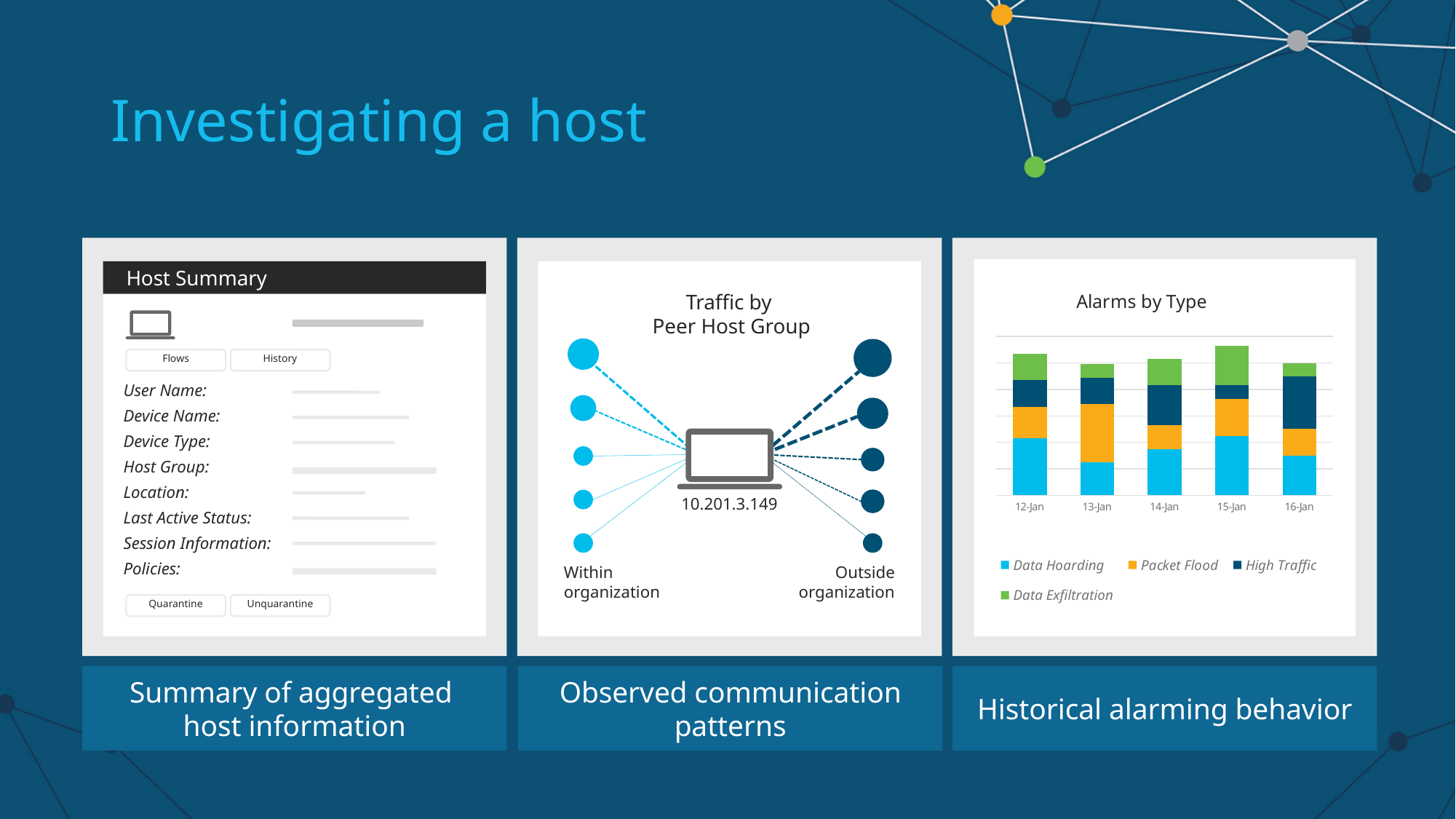
How many series does the legend of the Alarms by Type chart list? 4 What kind of chart is the Alarms by Type chart? Stacked bar chart Which series appears at the bottom of each stacked bar in the Alarms by Type chart? Data Hoarding In the Alarms by Type chart, is the total bar for 15-Jan or 13-Jan taller? 15-Jan How many dates are shown on the x axis of the Alarms by Type chart? 5 What is the first date shown on the x axis of the Alarms by Type chart? 12-Jan Which date has the tallest stacked bar in the Alarms by Type chart? 15-Jan Which date has the largest Packet Flood segment in the Alarms by Type chart? 13-Jan Which date has the smallest Data Hoarding segment in the Alarms by Type chart? 13-Jan In the Alarms by Type chart, is the Packet Flood segment larger on 13-Jan or 14-Jan? 13-Jan What is the title of the chart on the slide? Alarms by Type Which date has the largest Data Exfiltration segment in the Alarms by Type chart? 15-Jan